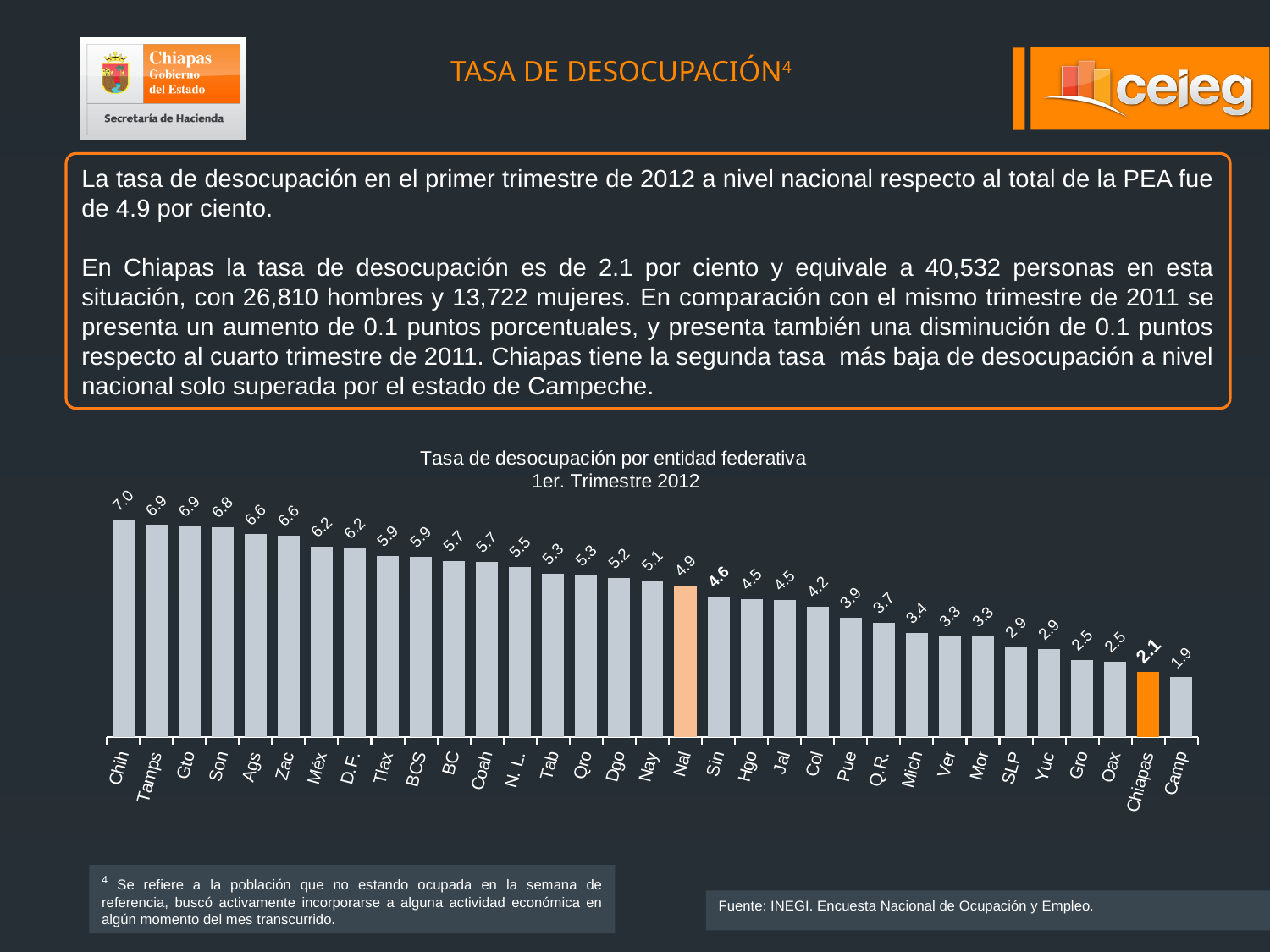
Which category has the highest value in the chart? Chih What kind of chart is shown on the slide? Bar chart What is the value for Chih in the chart? 7.0 What is the difference between the values for Nal and Chiapas? 2.8 What is the value for Chiapas in the chart? 2.1 Do the values rise or fall from left to right along the x axis? Fall How many bars are plotted in the chart? 33 What is the value for Camp in the chart? 1.9 Which category has the lowest value in the chart? Camp What is the value for Nal (national) in the chart? 4.9 What is the difference between the values for Chih and Camp? 5.1 Which has a larger value, Jal or Pue? Jal